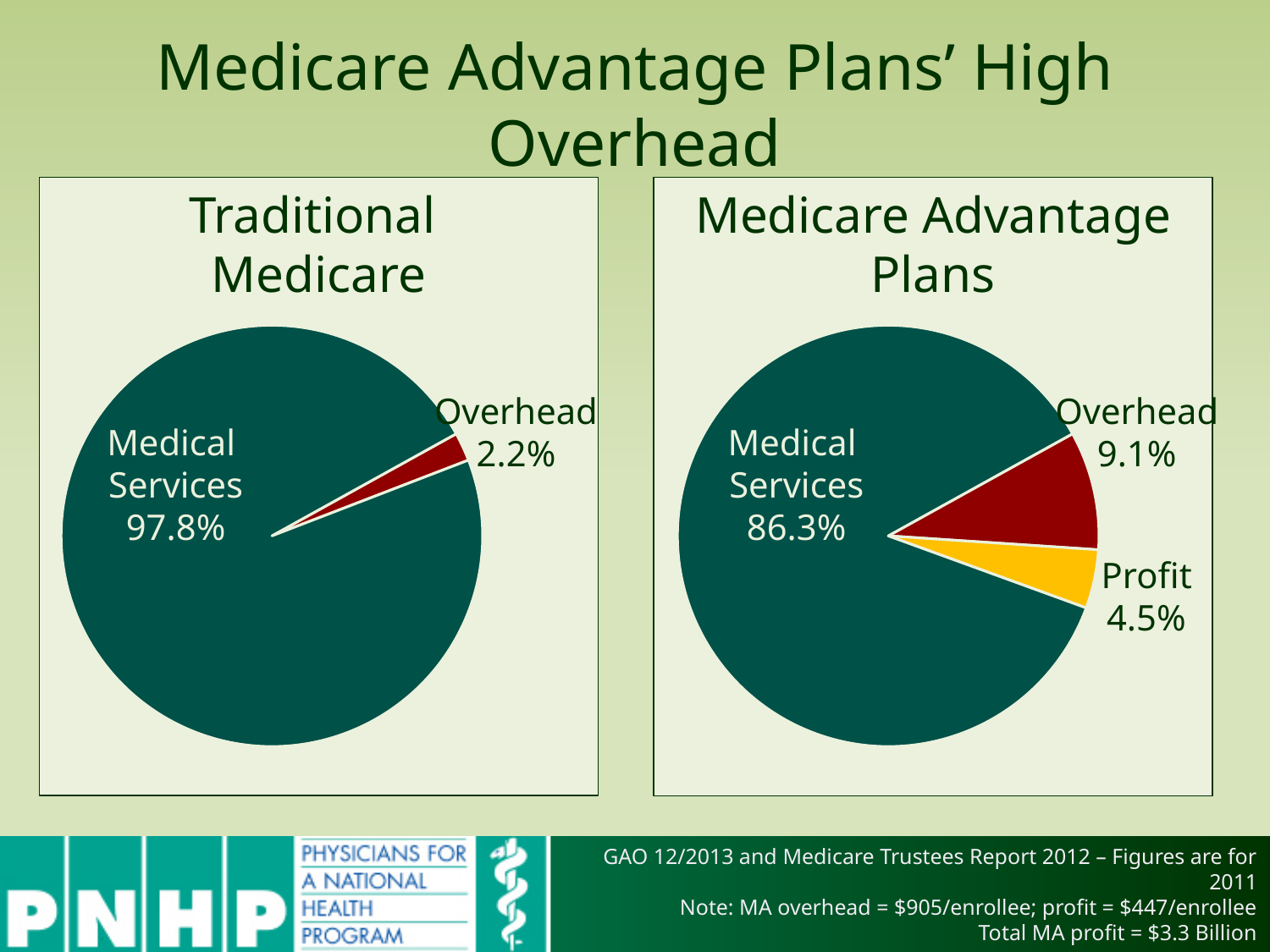
In the Medicare Advantage Plans chart, what share is Profit? 4.5% In the Medicare Advantage Plans chart, which slice is the largest? Medical Services How many slices does the Traditional Medicare chart have? 2 In the Medicare Advantage Plans chart, what share is Overhead? 9.1% What is the difference between the Overhead share in the Medicare Advantage Plans chart and the Overhead share in the Traditional Medicare chart? 6.9% In the Medicare Advantage Plans chart, what share is Medical Services? 86.3% What kind of chart is the Traditional Medicare chart? Pie chart In the Traditional Medicare chart, what share is Overhead? 2.2% In the Medicare Advantage Plans chart, which is larger, Overhead or Profit? Overhead In the Traditional Medicare chart, what share is Medical Services? 97.8% How many slices does the Medicare Advantage Plans chart have? 3 In the Medicare Advantage Plans chart, which slice is the smallest? Profit